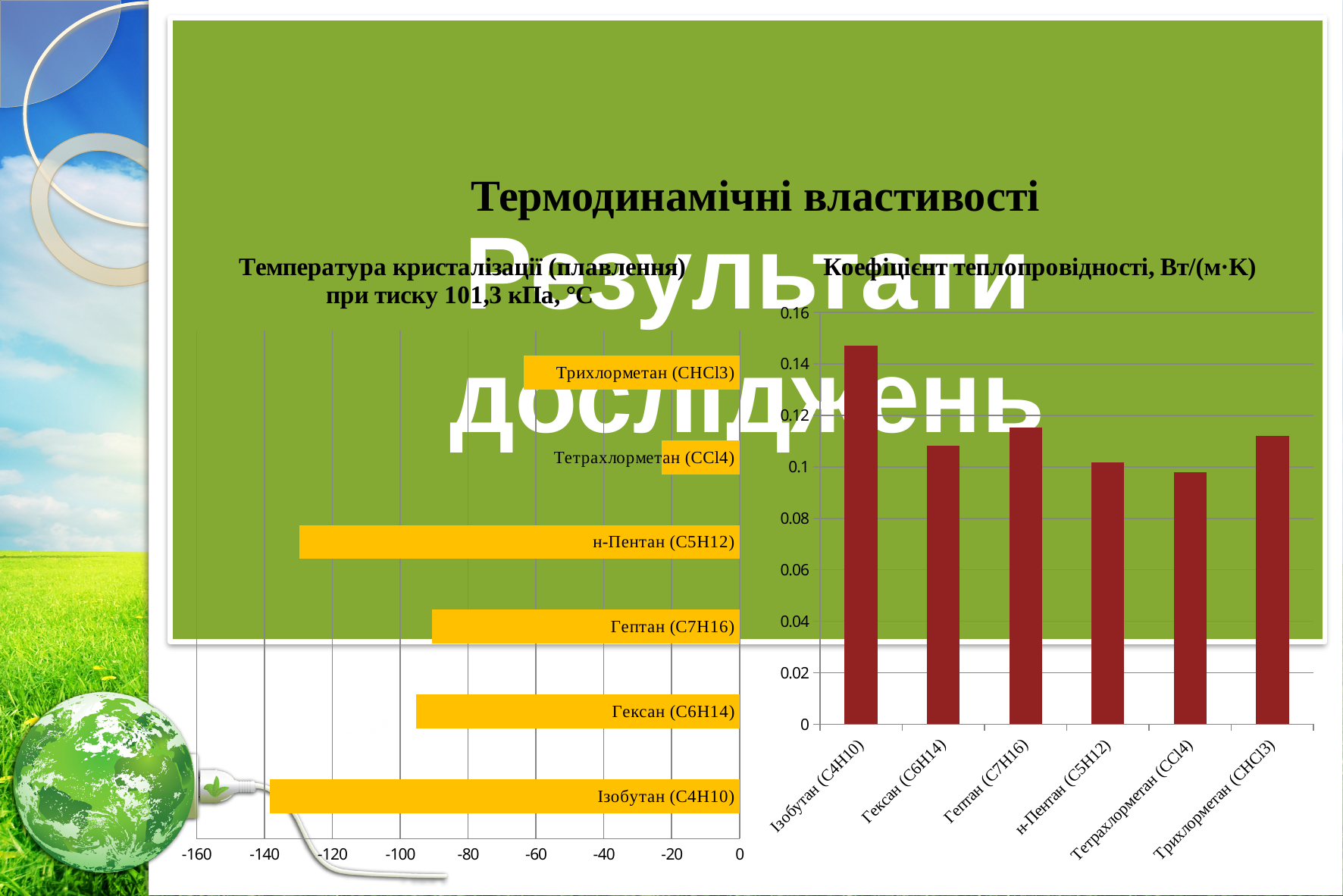
What kind of chart is the left chart titled "Температура кристалізації (плавлення) при тиску 101,3 кПа, °C"? bar chart In the left chart (Температура кристалізації), is the value for н-Пентан (C5H12) greater or less than -120? less How many bars are shown in the right chart (Коефіцієнт теплопровідності)? 6 What kind of chart is the right chart titled "Коефіцієнт теплопровідності, Вт/(м·К)"? bar chart In the left chart (Температура кристалізації), is the value for Трихлорметан (CHCl3) greater or less than -40? less In the right chart (Коефіцієнт теплопровідності), is the value for Ізобутан (C4H10) greater or less than 0.14? greater In the left chart (Температура кристалізації), which category has the highest (closest to zero) temperature? Тетрахлорметан (CCl4) In the right chart (Коефіцієнт теплопровідності), which category has the highest value? Ізобутан (C4H10) How many categories are shown in the left chart (Температура кристалізації)? 6 In the right chart (Коефіцієнт теплопровідності), which is larger: the value for Ізобутан (C4H10) or Трихлорметан (CHCl3)? Ізобутан (C4H10)